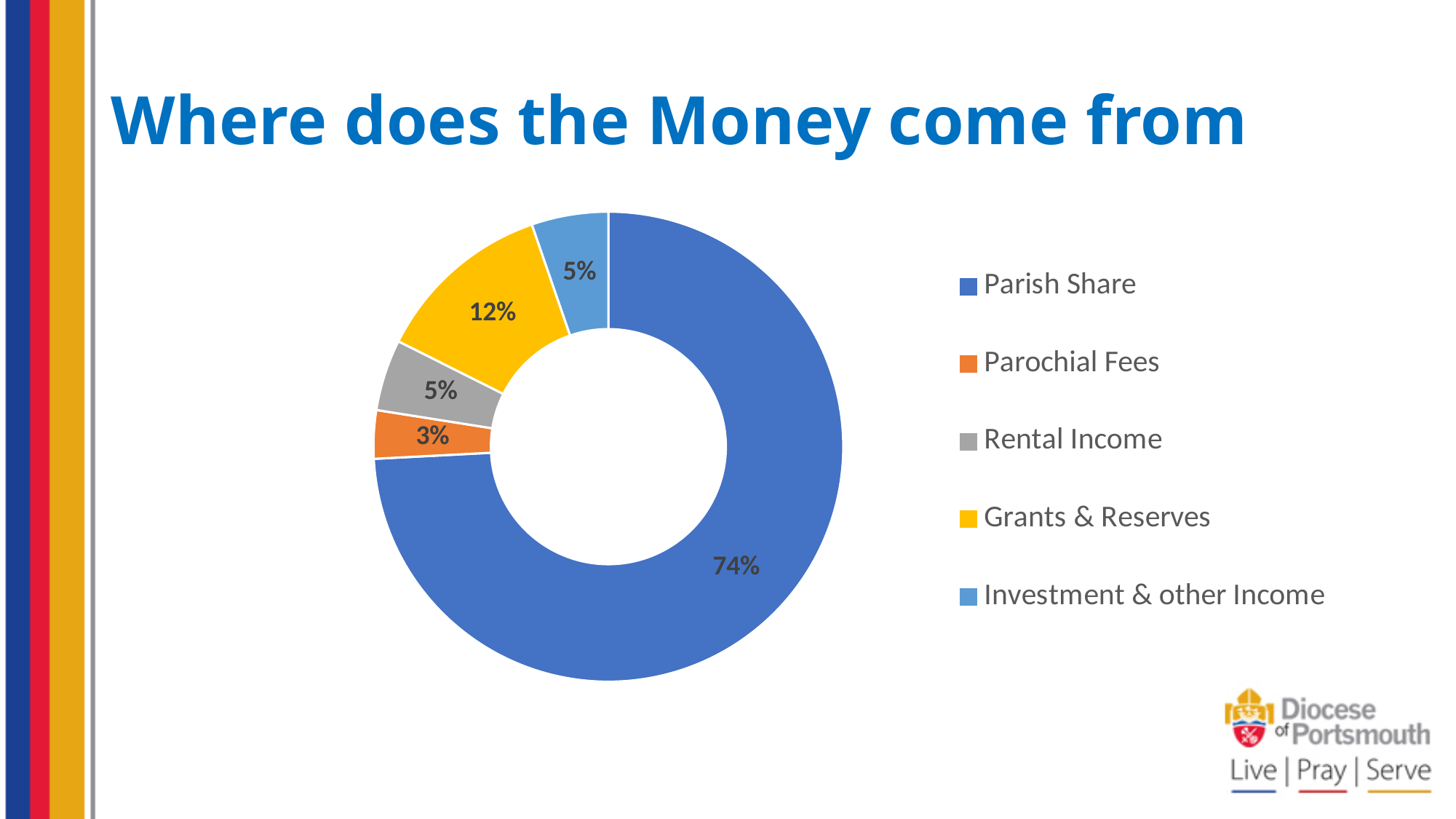
What percentage does Rental Income contribute? 5% How many income sources are shown in the chart? 5 Which source contributes the smallest share of the money? Parochial Fees What percentage does Parochial Fees contribute? 3% Which is larger, Grants & Reserves or Investment & other Income? Grants & Reserves What percentage does Grants & Reserves contribute? 12% What share of the money comes from Parish Share? 74% What is the title of the slide? Where does the Money come from Which source contributes the largest share of the money? Parish Share Which colour represents Rental Income in the chart? Grey How many percentage points larger is Parish Share than Grants & Reserves? 62 What kind of chart is shown on the slide? Doughnut (pie) chart